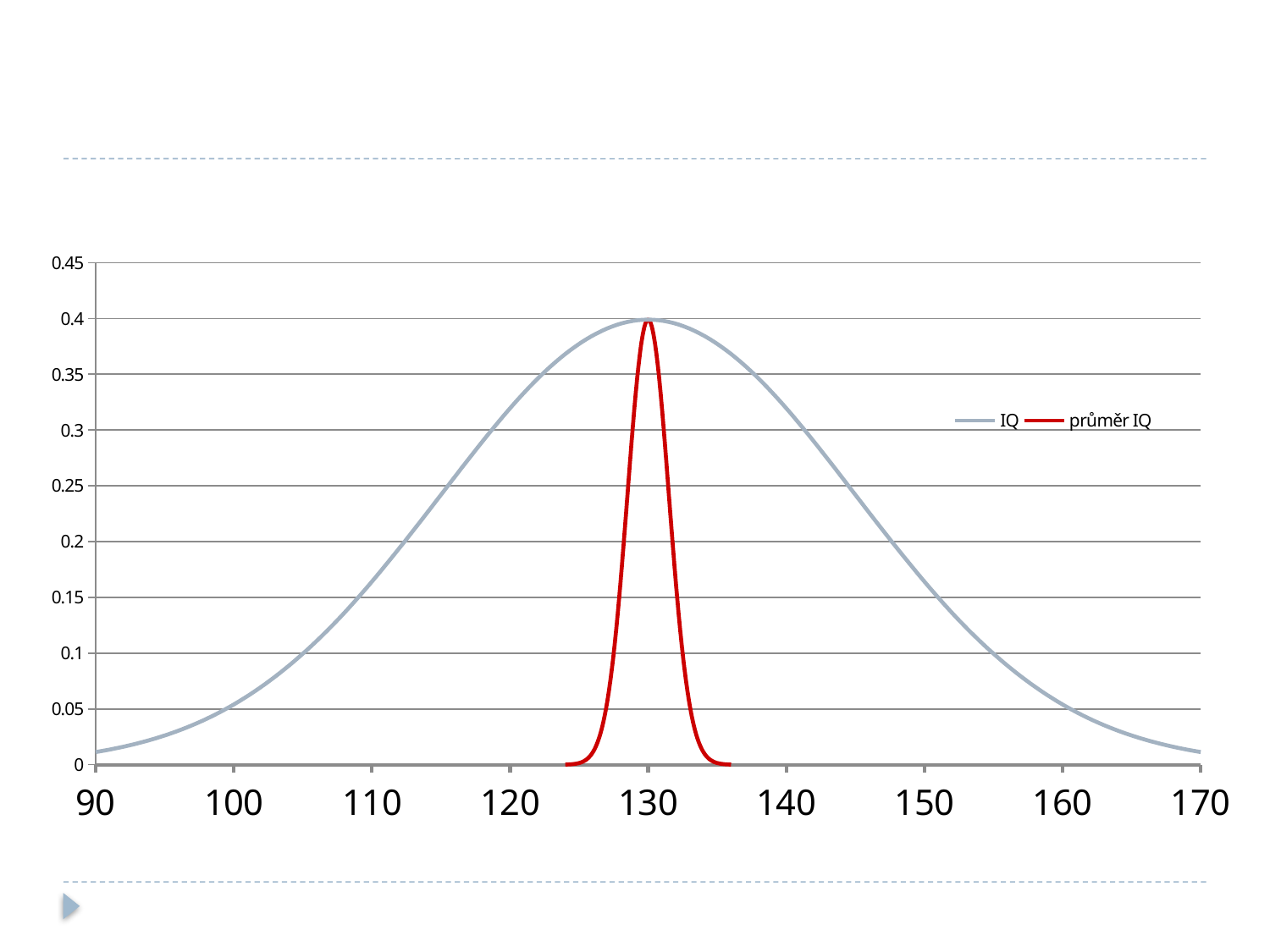
Is the value of the IQ series at x = 90 greater or less than 0.05? less At x = 120, which series has the higher value, IQ or průměr IQ? IQ Does the IQ series rise or fall as x goes from 90 to 130? rise What kind of chart is shown on the slide? line chart What are the two series named in the legend? IQ and průměr IQ Is the value of the průměr IQ series at x = 130 greater or less than 0.35? greater Is the value of the IQ series at x = 100 greater or less than 0.1? less At which x-axis value does the IQ curve reach its peak? 130 How many series does the legend list? 2 Which colour is used for the průměr IQ series? red Does the IQ series rise or fall as x goes from 130 to 170? fall